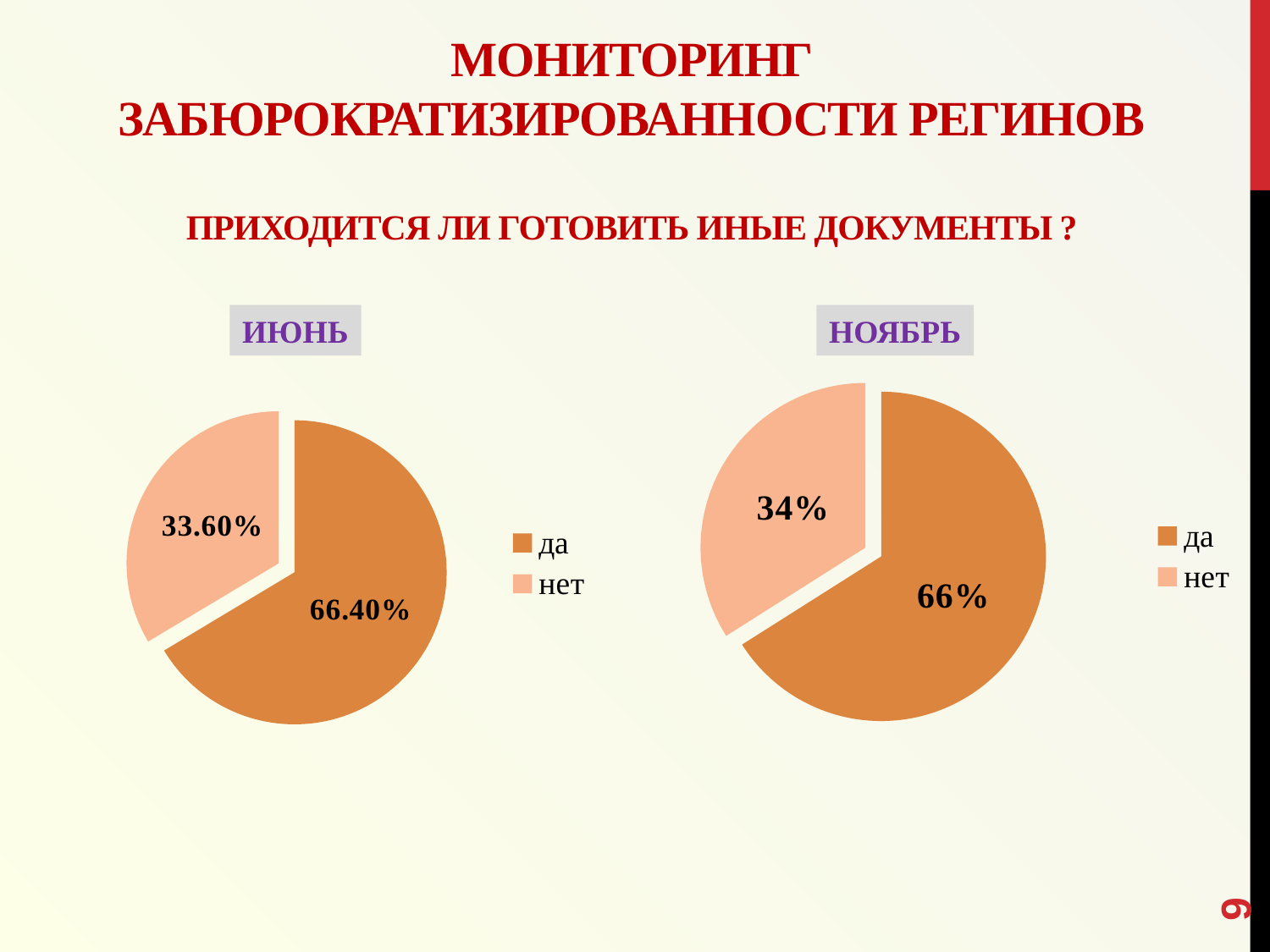
In the ИЮНЬ pie chart, what is the difference between the да and нет slices? 32.80% In the ИЮНЬ pie chart, what is the value for да? 66.40% In the НОЯБРЬ pie chart, which category has the smallest slice? нет How many pie charts are shown on the slide? 2 In the НОЯБРЬ pie chart, what is the value for нет? 34% In the ИЮНЬ pie chart, what is the value for нет? 33.60% How many categories does the legend of the НОЯБРЬ pie chart list? 2 What type of chart is the ИЮНЬ chart? pie chart In the ИЮНЬ pie chart, which category has the largest slice? да In the НОЯБРЬ pie chart, which is larger, да or нет? да In the НОЯБРЬ pie chart, what is the value for да? 66% In the НОЯБРЬ pie chart, what is the difference between the да and нет slices? 32%